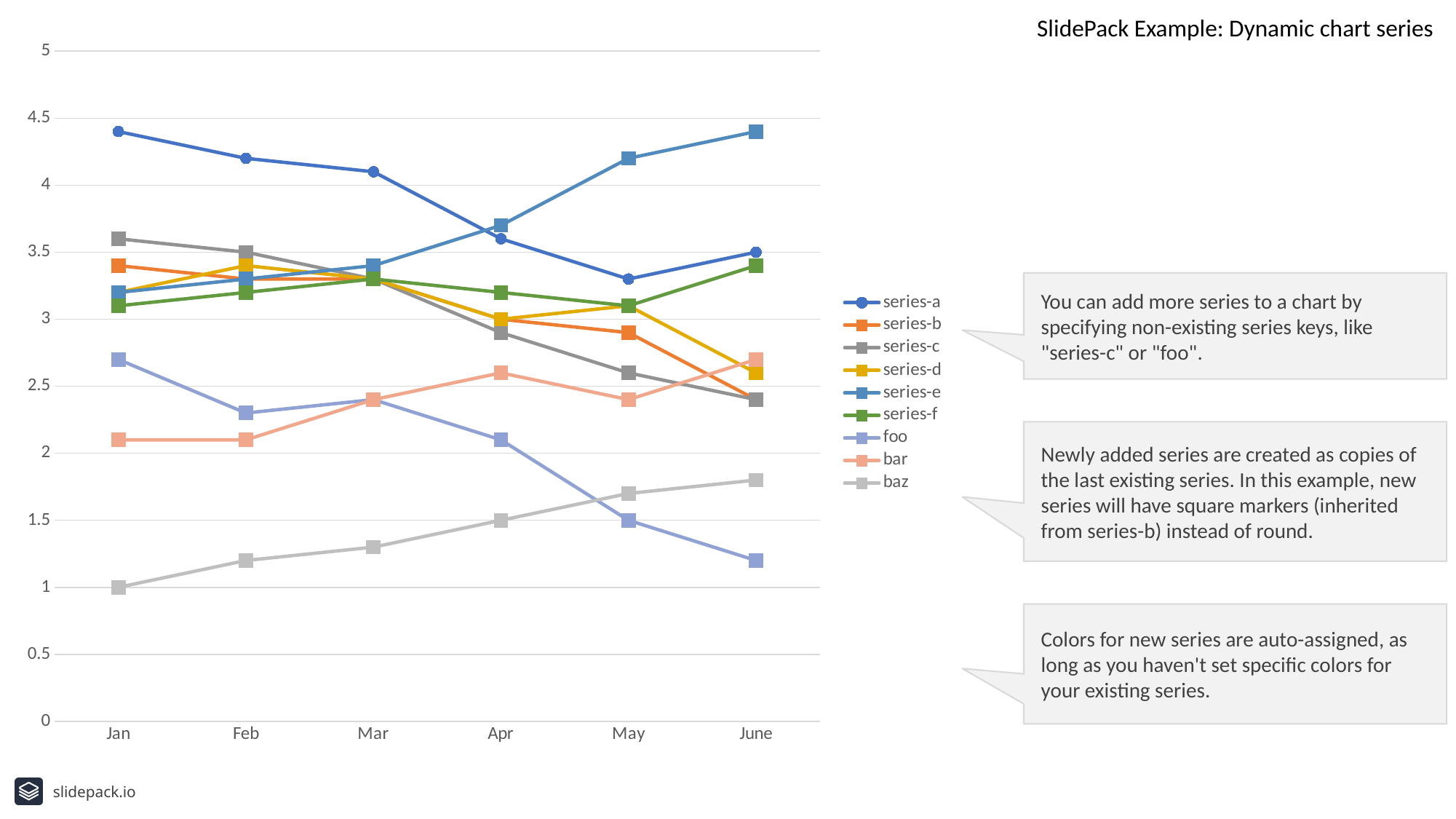
Is the value for series-a in Jan greater or less than 4? greater Does the baz series rise or fall from Jan to June? rise What is the value of baz in Jan? 1 What is the title of the slide containing the chart? SlidePack Example: Dynamic chart series What kind of chart is shown on the slide? line chart Which series has the highest value in June? series-e Is the value for baz in June greater or less than 2? less Which series has the highest value in Jan? series-a Which series has the lowest value in June? foo What is the value of series-c in Feb? 3.5 How many series does the chart legend list? 9 How many months are shown along the x axis of the chart? 6